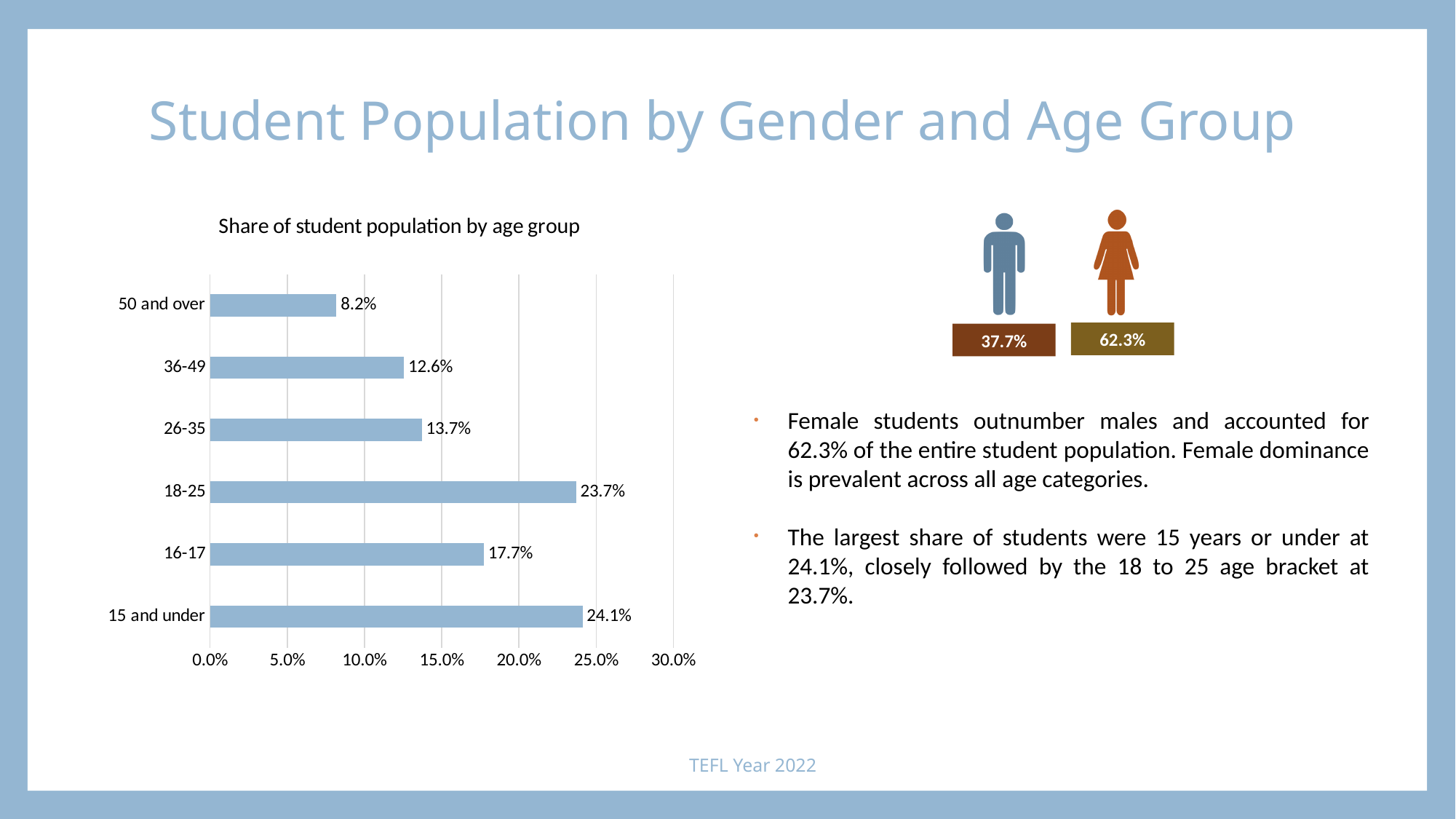
How many age groups are shown in the bar chart? 6 What type of chart is used to show the share of student population by age group? Bar chart Is the value for the 26-35 age group greater or less than 15.0%? less What is the share of the student population for the 16-17 age group? 17.7% What is the share of the student population for the 36-49 age group? 12.6% What is the share of the student population for the 15 and under age group? 24.1% What is the highest value shown on the x axis of the bar chart? 30.0% Which age group has a larger share, 16-17 or 36-49? 16-17 Which age group has the smallest share of the student population? 50 and over What is the title of the chart on the left of the slide? Share of student population by age group Which age group has the largest share of the student population? 15 and under What is the difference in share between the 18-25 and 26-35 age groups? 10.0%